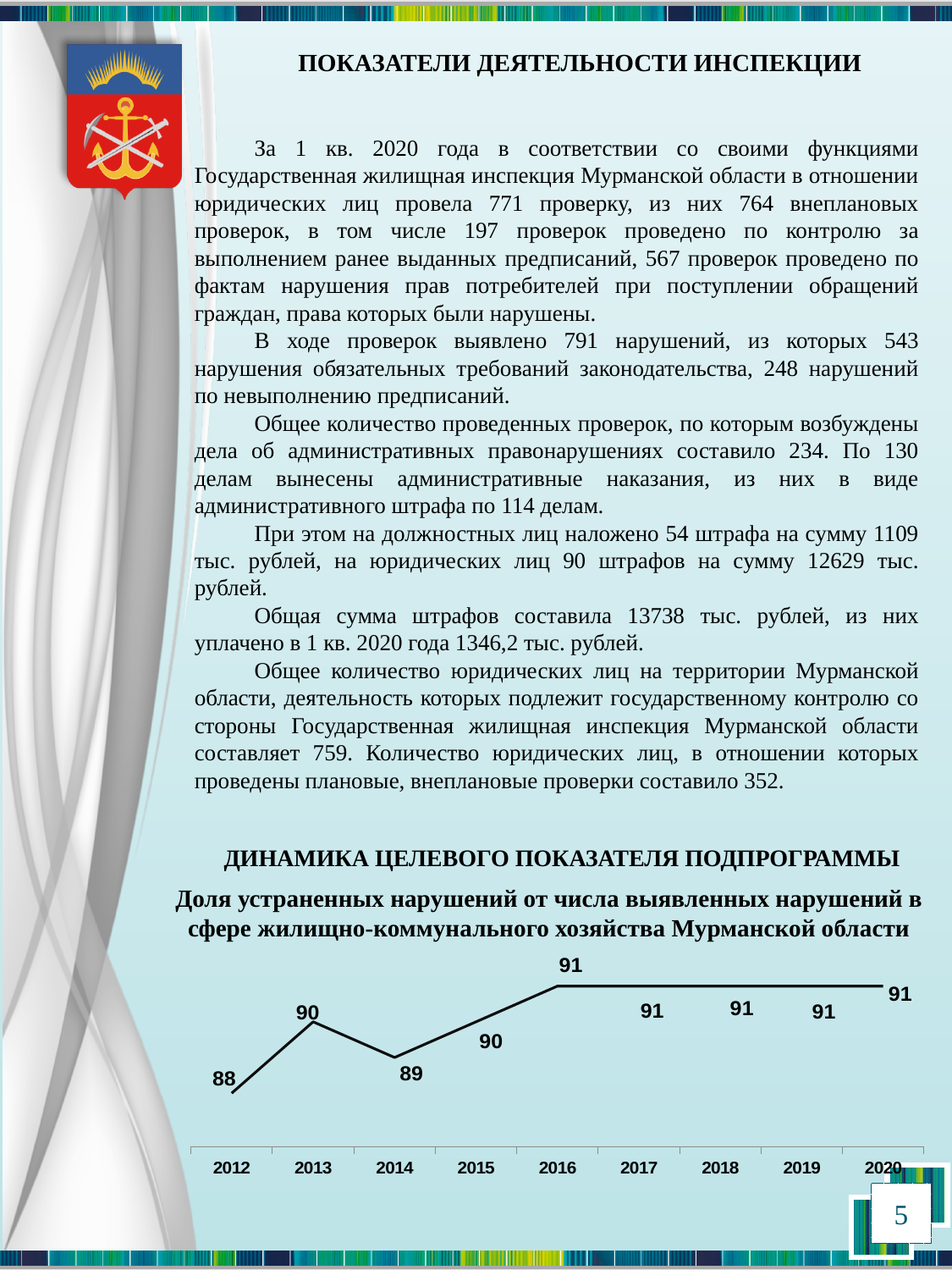
What is the difference between the values for 2013 and 2014? 1 How many years are plotted on the x axis? 9 What is the value for 2013? 90 What is the first year shown on the x axis? 2012 Which is larger, the value for 2013 or the value for 2014? 2013 What is the value for 2020? 91 Which year has the lowest value? 2012 What is the difference between the values for 2016 and 2012? 3 What is the value for 2014? 89 Do the values generally rise or fall from 2012 to 2020? rise What is the value for 2012? 88 What type of chart is shown on the slide? line chart